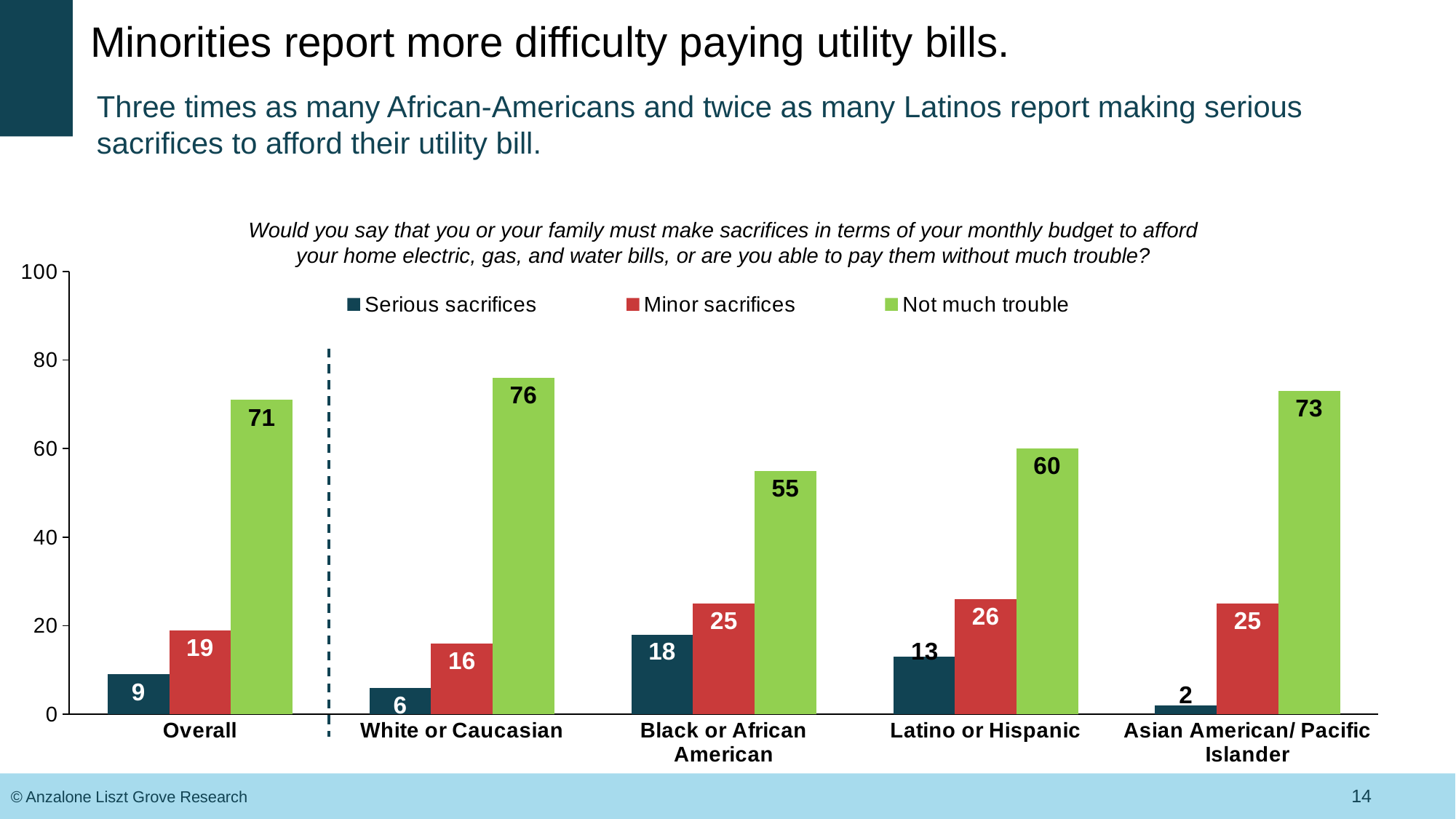
Which category has the highest value for Serious sacrifices? Black or African American What is the value for Not much trouble among White or Caucasian respondents? 76 Which category has the lowest value for Not much trouble? Black or African American Is the Not much trouble value for Latino or Hispanic greater or less than 80? less What is the difference between the Not much trouble values for White or Caucasian and Black or African American? 21 Which series is shown in green in the legend? Not much trouble What kind of chart is shown on the slide? Bar chart How many series does the legend list? 3 How many categories are shown on the x axis? 5 What is the value for Minor sacrifices among Latino or Hispanic respondents? 26 Which is larger: the Serious sacrifices value for Latino or Hispanic or for White or Caucasian? Latino or Hispanic What is the value for Serious sacrifices among Black or African American respondents? 18